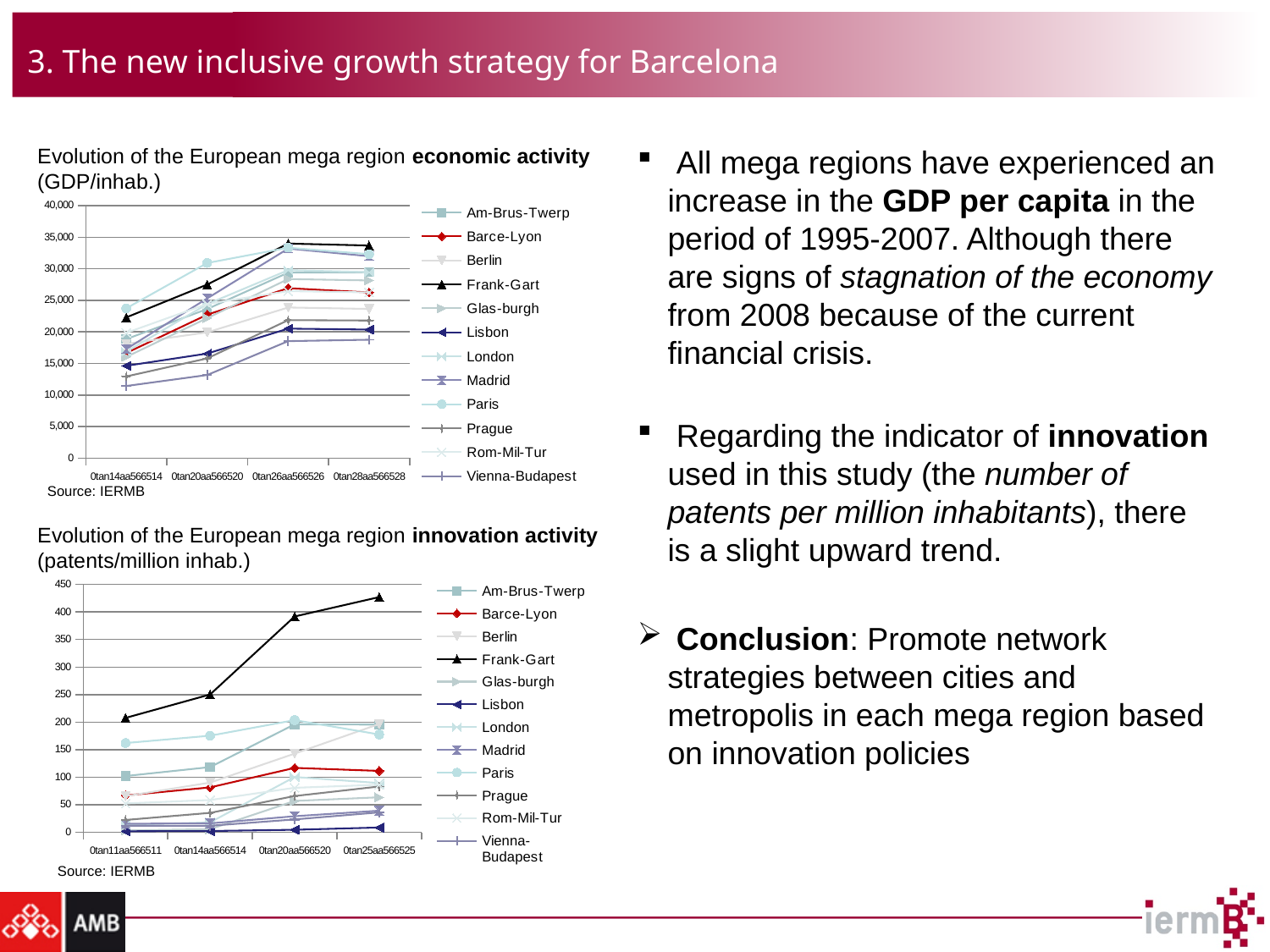
In the top chart (economic activity), which mega region has the lowest values throughout? Vienna-Budapest In the bottom chart (innovation activity), which mega region has the lowest values? Lisbon In the bottom chart (innovation activity), does the Frank-Gart series rise or fall along the x axis? rise In the bottom chart (innovation activity), is the value for Frank-Gart at the last point greater or less than 400? greater How many series does the legend of the top chart (economic activity) list? 12 In the top chart (economic activity), which mega region reaches the highest GDP per inhabitant? Frank-Gart In the bottom chart (innovation activity), which mega region has the highest number of patents per million inhabitants? Frank-Gart In the top chart (economic activity), is the value for Frank-Gart at the last point greater or less than 30,000? greater In the top chart (economic activity), is the value for Vienna-Budapest at the first point greater or less than 15,000? less What source is cited below both charts? IERMB What kind of chart is the top chart, 'Evolution of the European mega region economic activity'? line chart How many points along the x axis does the bottom chart (innovation activity) have? 4